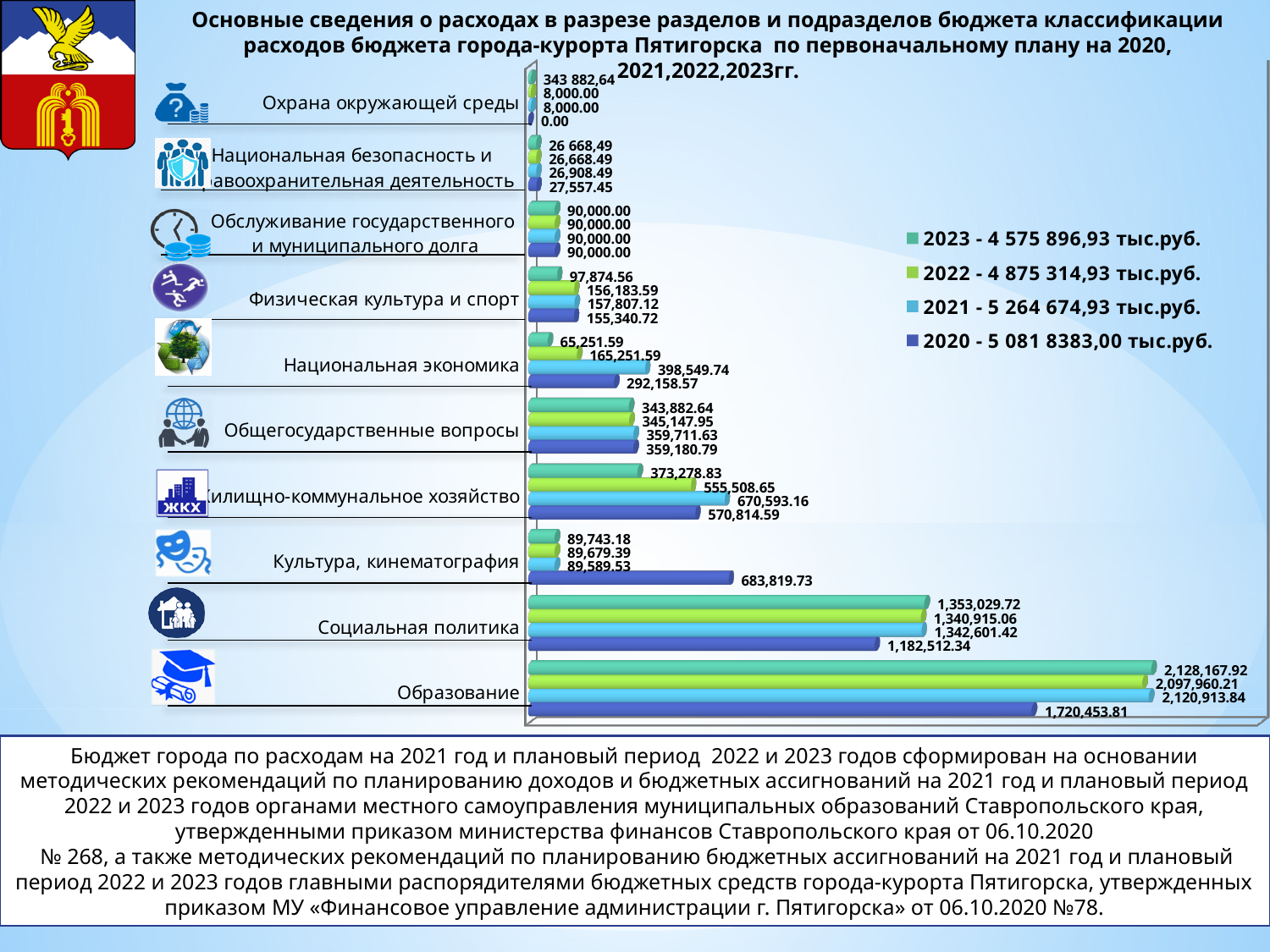
How many series does the chart's legend list? 4 According to the legend, what is the total for 2021? 5 264 674,93 тыс.руб. What is the difference between the 2023 and 2020 values for Образование? 407,714.11 What kind of chart is shown on the slide? bar chart What is the value for Культура, кинематография in the 2020 series? 683,819.73 What is the value for Социальная политика in the 2023 series? 1,353,029.72 How many expenditure categories are plotted on the chart? 10 What is the value for Образование in the 2020 series? 1,720,453.81 Which category has the highest value in the 2023 series? Образование What is the value for Национальная экономика in the 2021 series? 398,549.74 For Жилищно-коммунальное хозяйство, which series has the larger value: 2021 or 2020? 2021 What is the value for Обслуживание государственного и муниципального долга in the 2021 series? 90,000.00